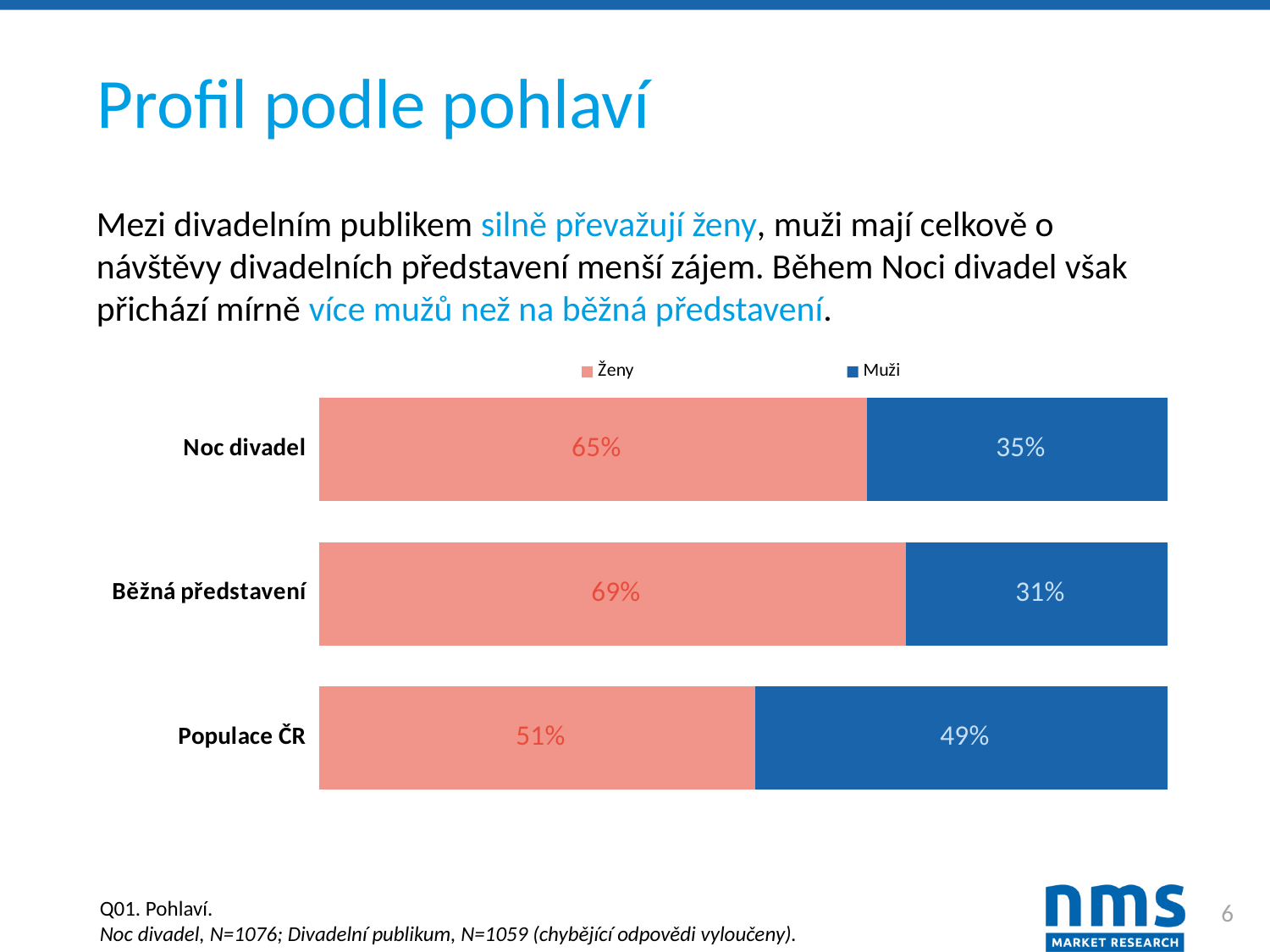
Which is larger: the Muži value for Noc divadel or the Muži value for Populace ČR? Populace ČR Which category has the lowest value for Muži? Běžná představení Which series is shown in blue in the legend? Muži What is the total of the Noc divadel stacked bar? 100% How many series does the legend list? 2 What is the value for Ženy in the Noc divadel bar? 65% Which category has the highest value for Ženy? Běžná představení What is the value for Muži in the Běžná představení bar? 31% What kind of chart is shown on the slide? Stacked bar chart How many categories are shown on the chart? 3 What is the value for Ženy in the Populace ČR bar? 51% What is the difference between the Ženy values for Běžná představení and Noc divadel? 4%